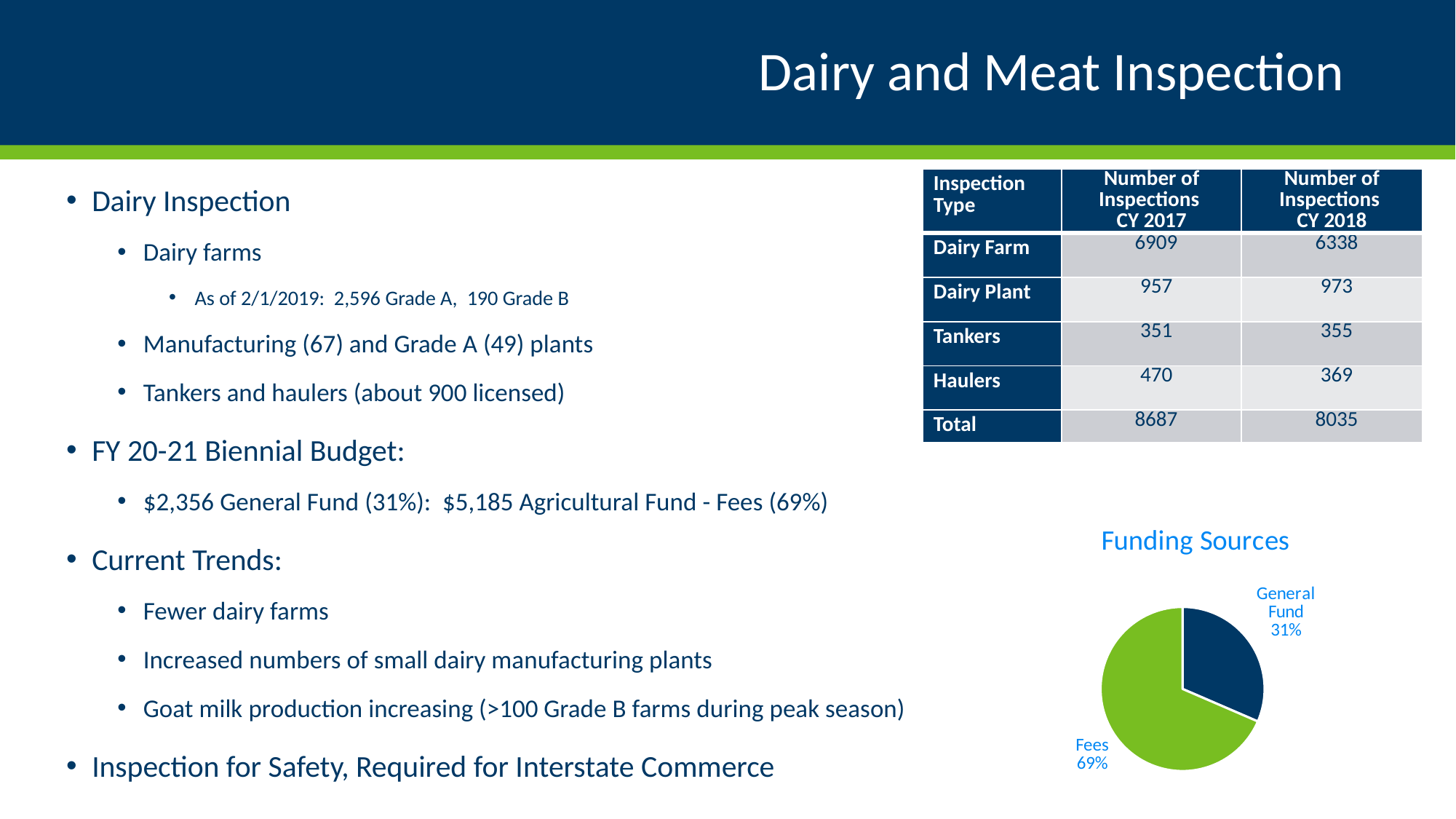
What is the difference in percentage points between the Fees and General Fund slices in the Funding Sources pie chart? 38 In the Funding Sources pie chart, which is larger, Fees or General Fund? Fees What colour is the Fees slice in the Funding Sources pie chart? green What is the title of the pie chart? Funding Sources What kind of chart is the Funding Sources chart? pie chart What share of the Funding Sources pie is Fees? 69% Which slice of the Funding Sources pie is the smallest? General Fund How many slices does the Funding Sources pie chart have? 2 What share of the Funding Sources pie is General Fund? 31% Which slice of the Funding Sources pie is the largest? Fees